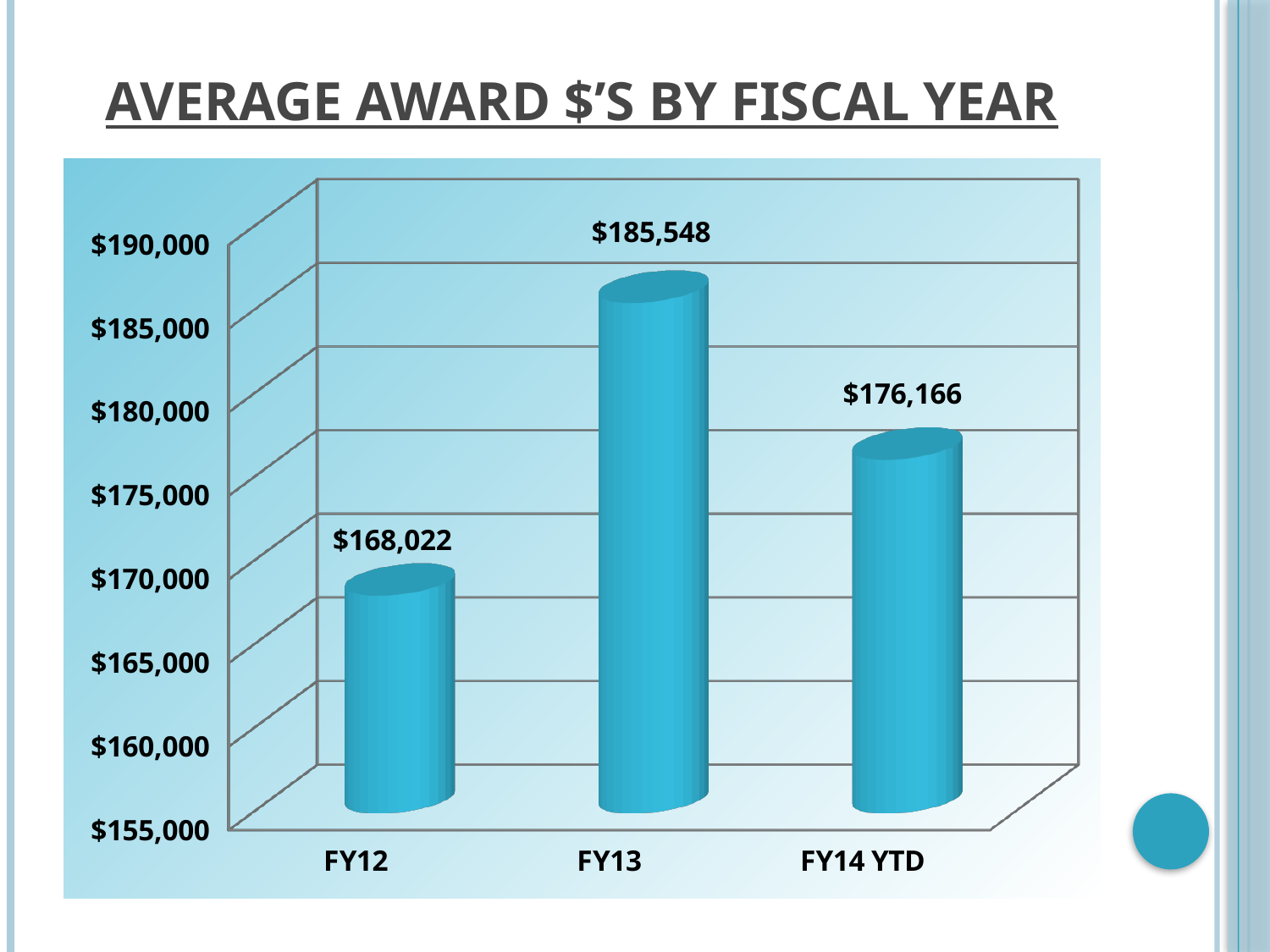
What is the difference between the average award amounts for FY13 and FY14 YTD? $9,382 Is the value for FY14 YTD greater or less than $180,000? less Which fiscal year has the highest average award amount? FY13 Which is larger, the average award amount for FY14 YTD or for FY12? FY14 YTD What is the average award amount for FY13? $185,548 What is the title of the chart? Average Award $'s by Fiscal Year What is the average award amount for FY14 YTD? $176,166 What is the average award amount for FY12? $168,022 What is the difference between the average award amounts for FY13 and FY12? $17,526 What kind of chart is shown on the slide? bar chart How many fiscal years are shown in the chart? 3 Which fiscal year has the lowest average award amount? FY12